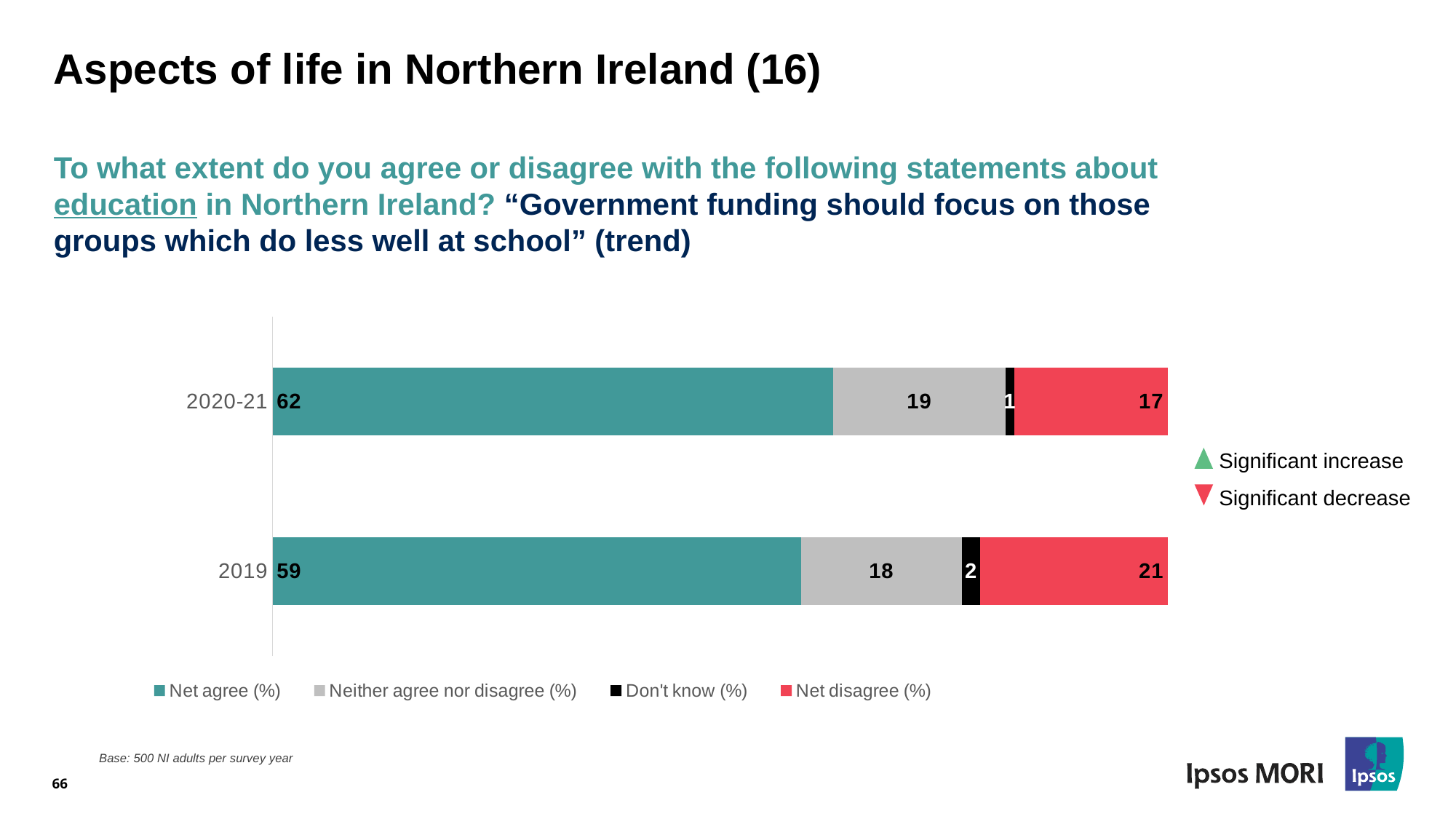
What is the Net disagree (%) value for 2019? 21 Is the Neither agree nor disagree (%) value larger for 2020-21 or 2019? 2020-21 Which year has the lower Net disagree (%) value? 2020-21 How many years are shown in the chart? 2 What is the Net agree (%) value for 2020-21? 62 Which year has the higher Net agree (%) value? 2020-21 What is the difference in Net agree (%) between 2020-21 and 2019? 3 What is the difference in Net disagree (%) between 2019 and 2020-21? 4 What is the Neither agree nor disagree (%) value for 2020-21? 19 How many series does the chart legend list? 4 What kind of chart is shown on the slide? Stacked bar chart What is the Don't know (%) value for 2019? 2